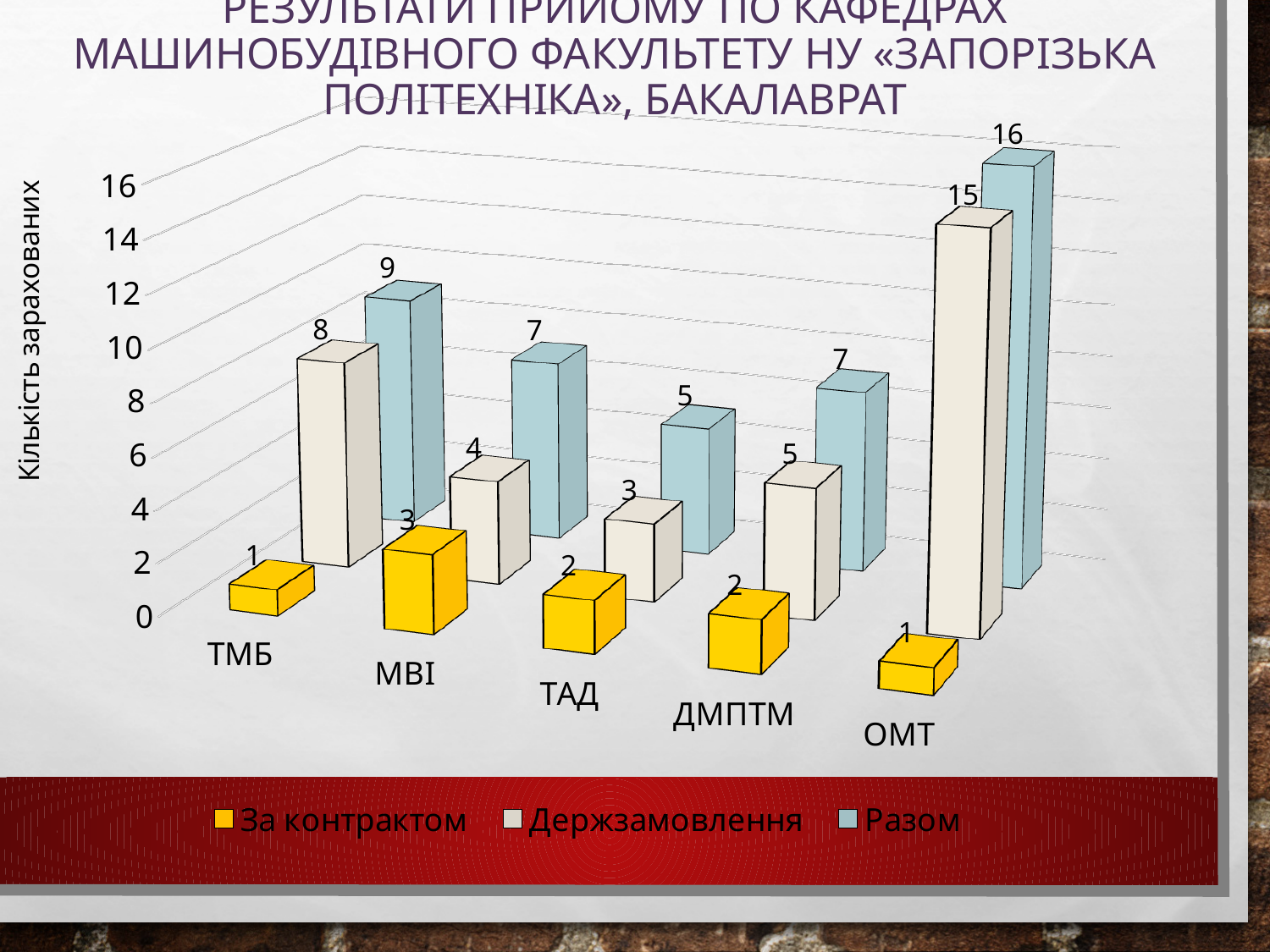
What is the value of За контрактом for МВІ? 3 What is the label of the vertical axis? Кількість зарахованих Which is larger: Держзамовлення for ТМБ or Держзамовлення for ДМПТМ? ТМБ What is the value of Разом for ТАД? 5 How many categories are shown on the x axis? 5 Which category has the highest Разом value? ОМТ How many series does the legend list? 3 Which series is shown in yellow according to the legend? За контрактом Which category has the lowest Разом value? ТАД What is the difference between the Разом values for ОМТ and ТМБ? 7 What is the value of Держзамовлення for ОМТ? 15 What kind of chart is shown on the slide? bar chart